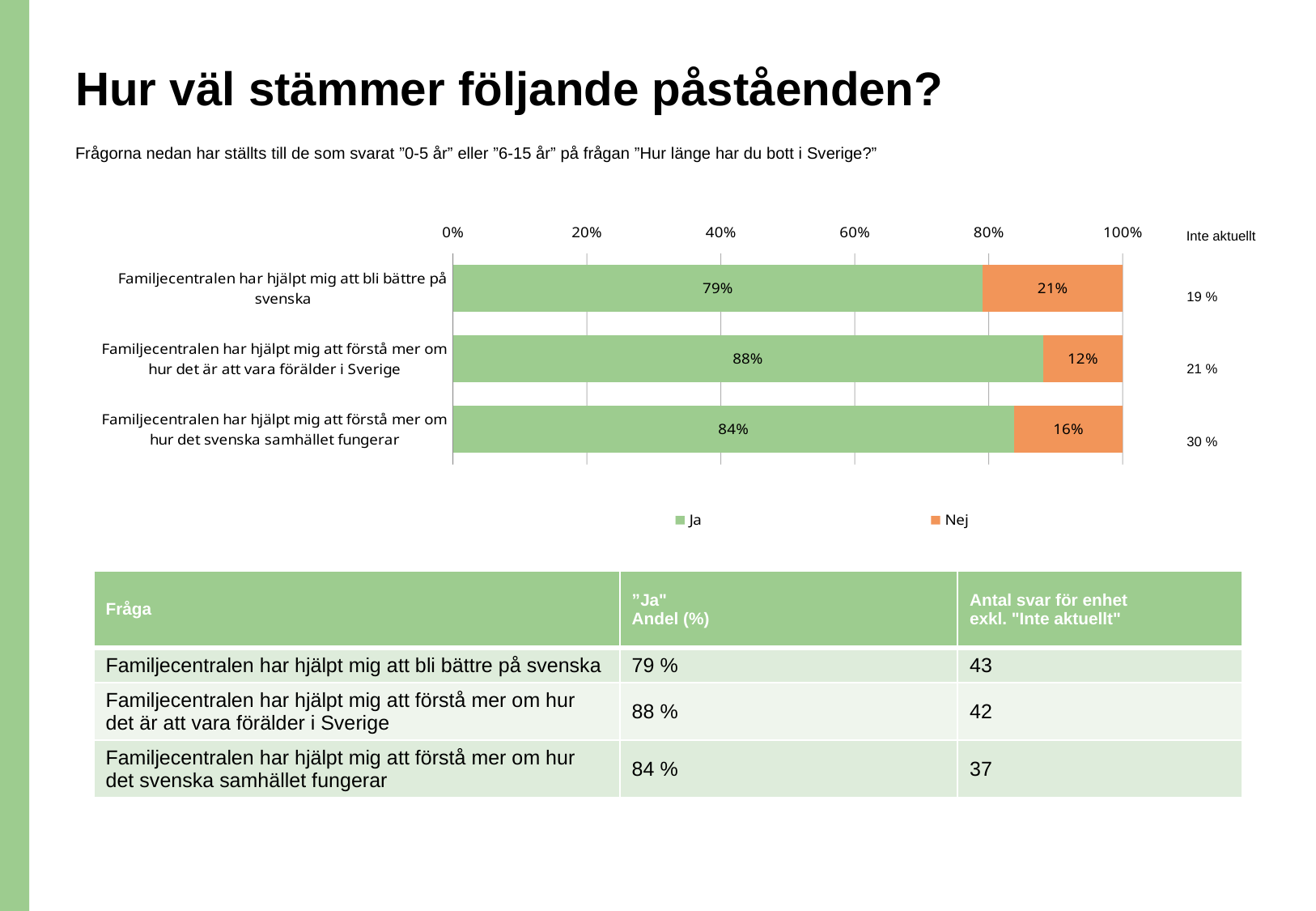
What is the "Ja" value for "Familjecentralen har hjälpt mig att bli bättre på svenska"? 79% How many statements (categories) are shown in the chart? 3 What is the "Ja" value for "Familjecentralen har hjälpt mig att förstå mer om hur det svenska samhället fungerar"? 84% How many series does the legend list? 2 Which statement has the lowest "Ja" share? Familjecentralen har hjälpt mig att bli bättre på svenska What kind of chart is shown on the slide? Stacked bar chart Which statement has the highest "Ja" share? Familjecentralen har hjälpt mig att förstå mer om hur det är att vara förälder i Sverige What is the total of the stacked bar for "Familjecentralen har hjälpt mig att förstå mer om hur det är att vara förälder i Sverige"? 100% Which is larger: the "Ja" share for "Familjecentralen har hjälpt mig att förstå mer om hur det svenska samhället fungerar" or for "Familjecentralen har hjälpt mig att bli bättre på svenska"? Familjecentralen har hjälpt mig att förstå mer om hur det svenska samhället fungerar What are the two series named in the legend? Ja and Nej What is the "Nej" value for "Familjecentralen har hjälpt mig att förstå mer om hur det är att vara förälder i Sverige"? 12% What is the difference in "Nej" share between "Familjecentralen har hjälpt mig att bli bättre på svenska" and "Familjecentralen har hjälpt mig att förstå mer om hur det svenska samhället fungerar"? 5 percentage points